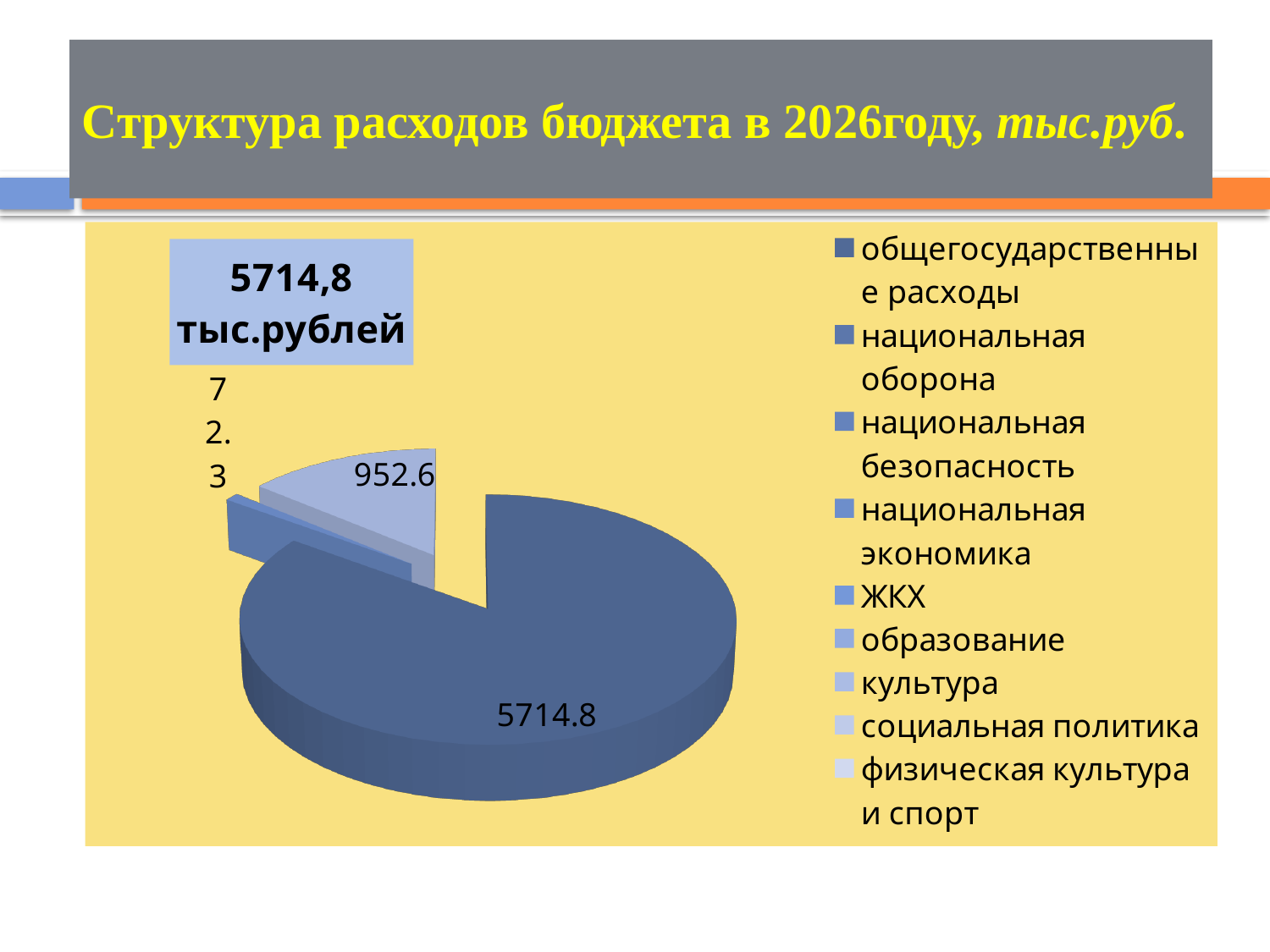
What is the difference between the slice labelled 5714.8 and the slice labelled 952.6? 4762.2 Which is larger, the slice labelled 5714.8 or the slice labelled 952.6? 5714.8 What is the value printed on the largest slice of the pie chart? 5714.8 Which category has the largest slice in the pie chart? общегосударственные расходы What kind of chart is shown on the slide? pie chart What is the value printed on the light blue slice pulled out from the pie chart? 952.6 What is the last entry in the pie chart's legend? физическая культура и спорт How many categories does the legend of the pie chart list? 9 What is the title shown above the pie chart? 5714,8 тыс.рублей